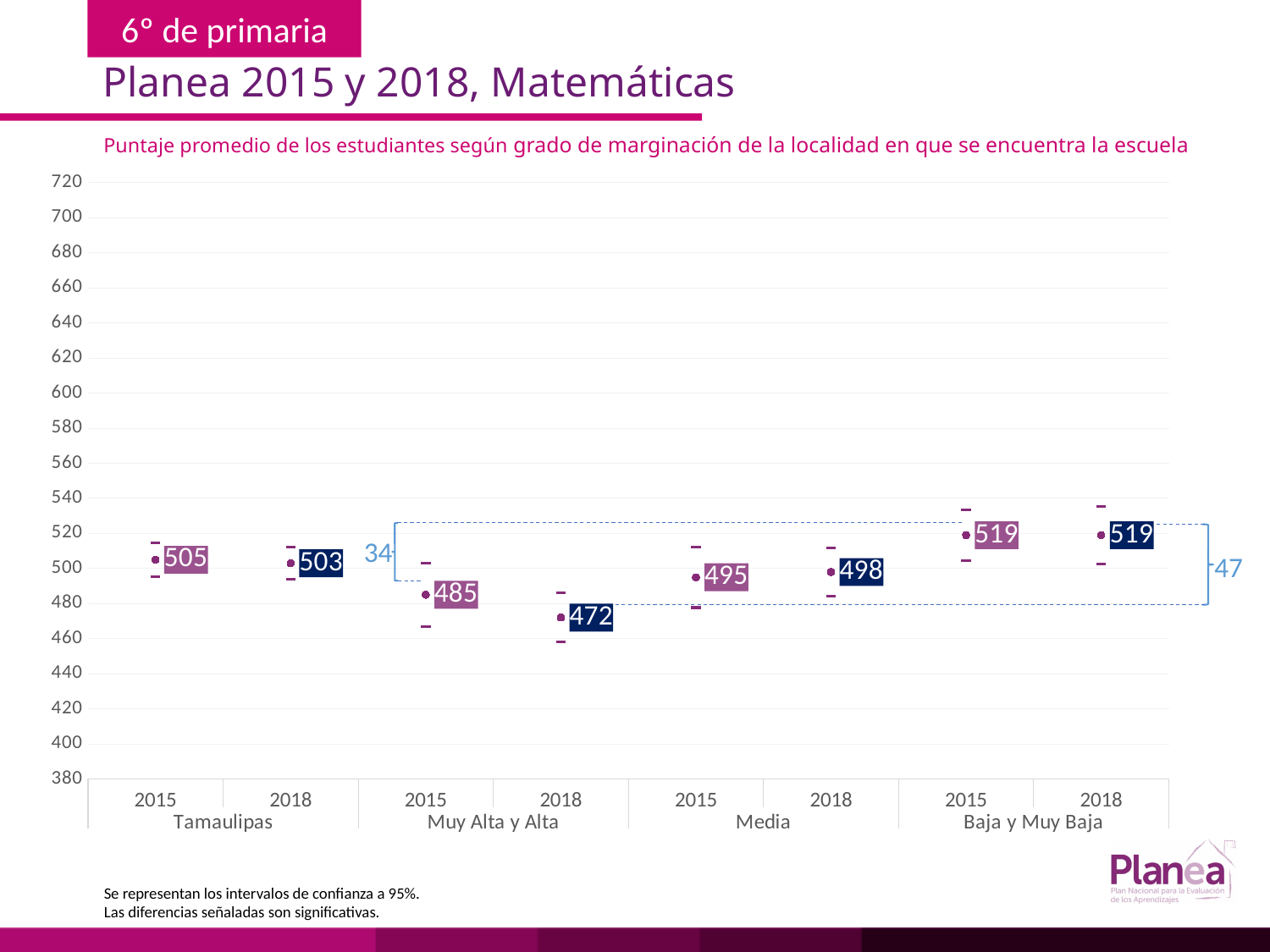
What confidence level do the intervals on the chart represent, according to the note? 95% What is the average score for the Media group in 2018? 498 What is the average score for the Muy Alta y Alta marginación group in 2018? 472 What is the difference between the Baja y Muy Baja score and the Muy Alta y Alta score in 2018? 47 How many marginación groups (including Tamaulipas) are shown on the x axis? 4 What is the average score for Tamaulipas in 2015? 505 Which is larger, the Media score in 2015 or the Media score in 2018? Media 2018 (498) Which group and year has the lowest average score on the chart? Muy Alta y Alta, 2018 How many data points are plotted on the chart? 8 What is the average score for the Baja y Muy Baja group in 2015? 519 Did the Muy Alta y Alta score rise or fall from 2015 to 2018? fall What is the difference between the Baja y Muy Baja score and the Muy Alta y Alta score in 2015? 34